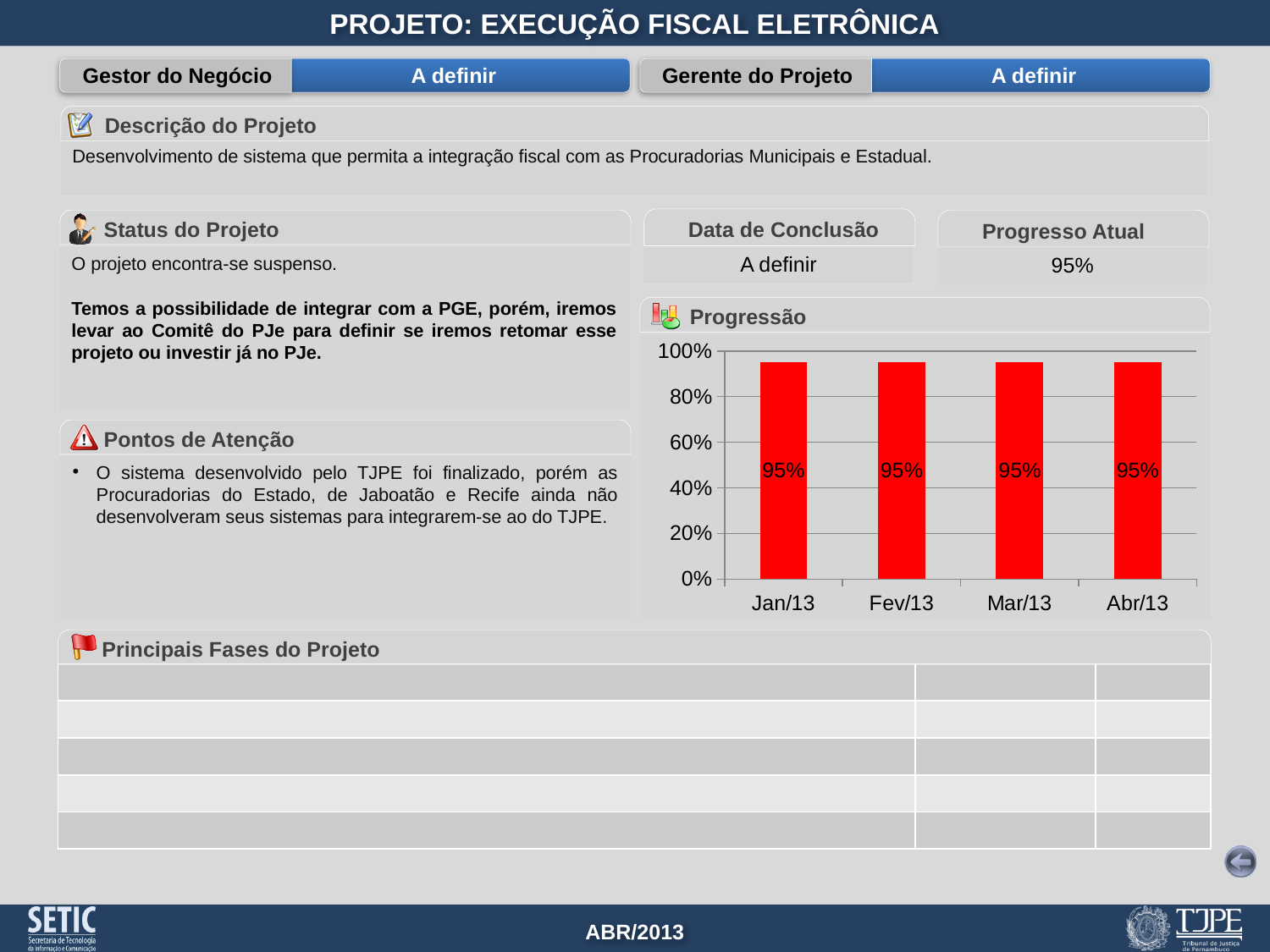
How many categories are shown on the x axis of the Progressão chart? 4 What is the highest value shown on the y axis of the Progressão chart? 100% Is the value for Fev/13 in the Progressão chart greater or less than 80%? greater What colour are the bars in the Progressão chart? red What is the value for Abr/13 in the Progressão chart? 95% Do the values in the Progressão chart rise, fall or stay the same from Jan/13 to Abr/13? stay the same What kind of chart is the Progressão chart? bar chart What is the title of the chart on the slide? Progressão What is the difference between the values for Fev/13 and Jan/13 in the Progressão chart? 0% What is the value for Jan/13 in the Progressão chart? 95% What is the value for Mar/13 in the Progressão chart? 95%